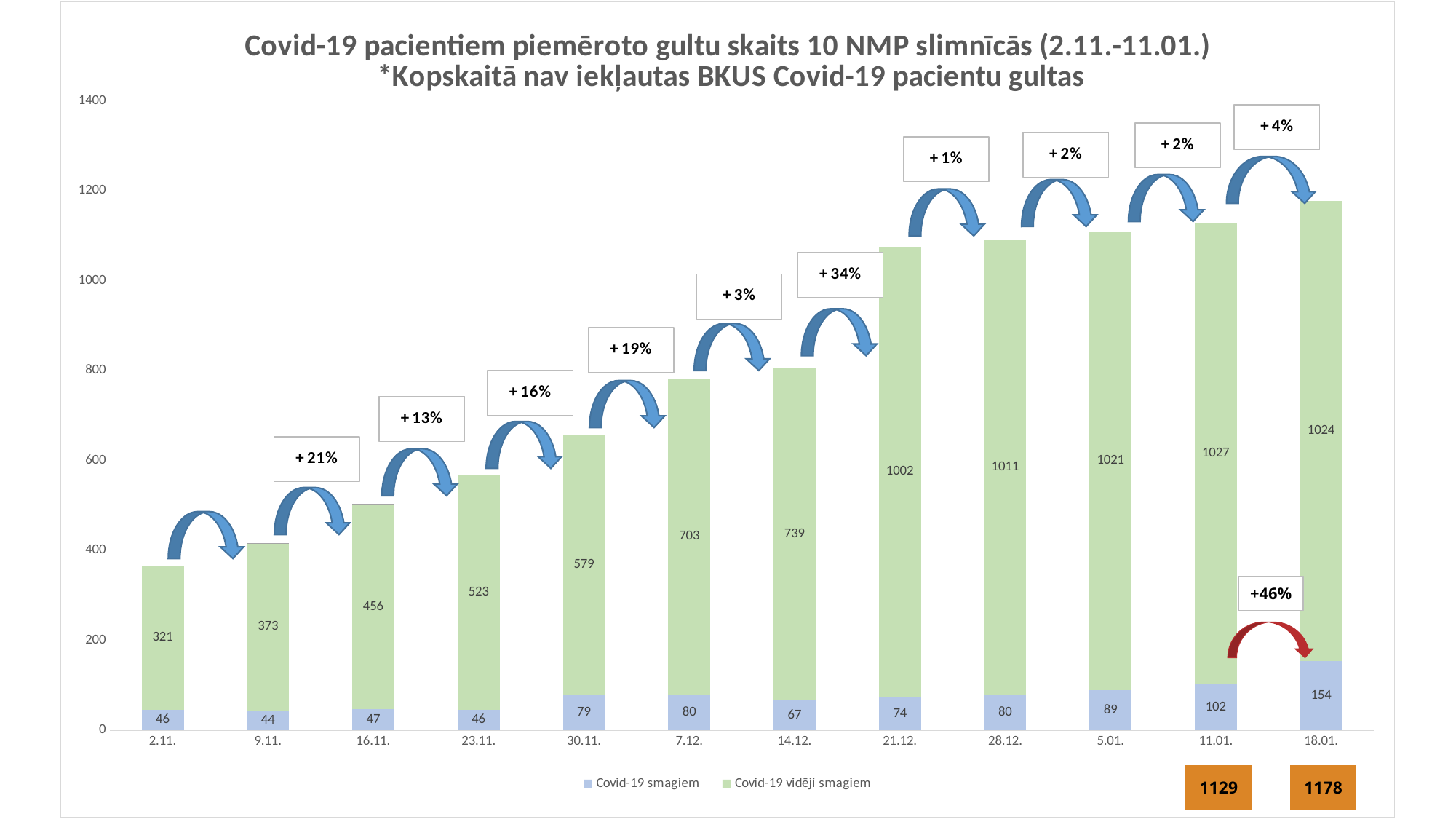
On which date is the Covid-19 vidēji smagiem value lowest? 2.11. What is the difference between the Covid-19 vidēji smagiem values on 21.12. and 14.12.? 263 On which date is the Covid-19 smagiem value highest? 18.01. Is the total stacked bar for 21.12. greater or less than 1000? greater Which is larger: the Covid-19 smagiem value on 30.11. or on 14.12.? 30.11. What percentage change is shown in the box between 14.12. and 21.12.? + 34% What is the value for Covid-19 vidēji smagiem on 7.12.? 703 What is the value for Covid-19 smagiem on 18.01.? 154 How many dates are shown on the x axis? 12 What kind of chart is shown on the slide? stacked bar chart How many series does the legend list? 2 What is the total of the stacked bar for 11.01.? 1129